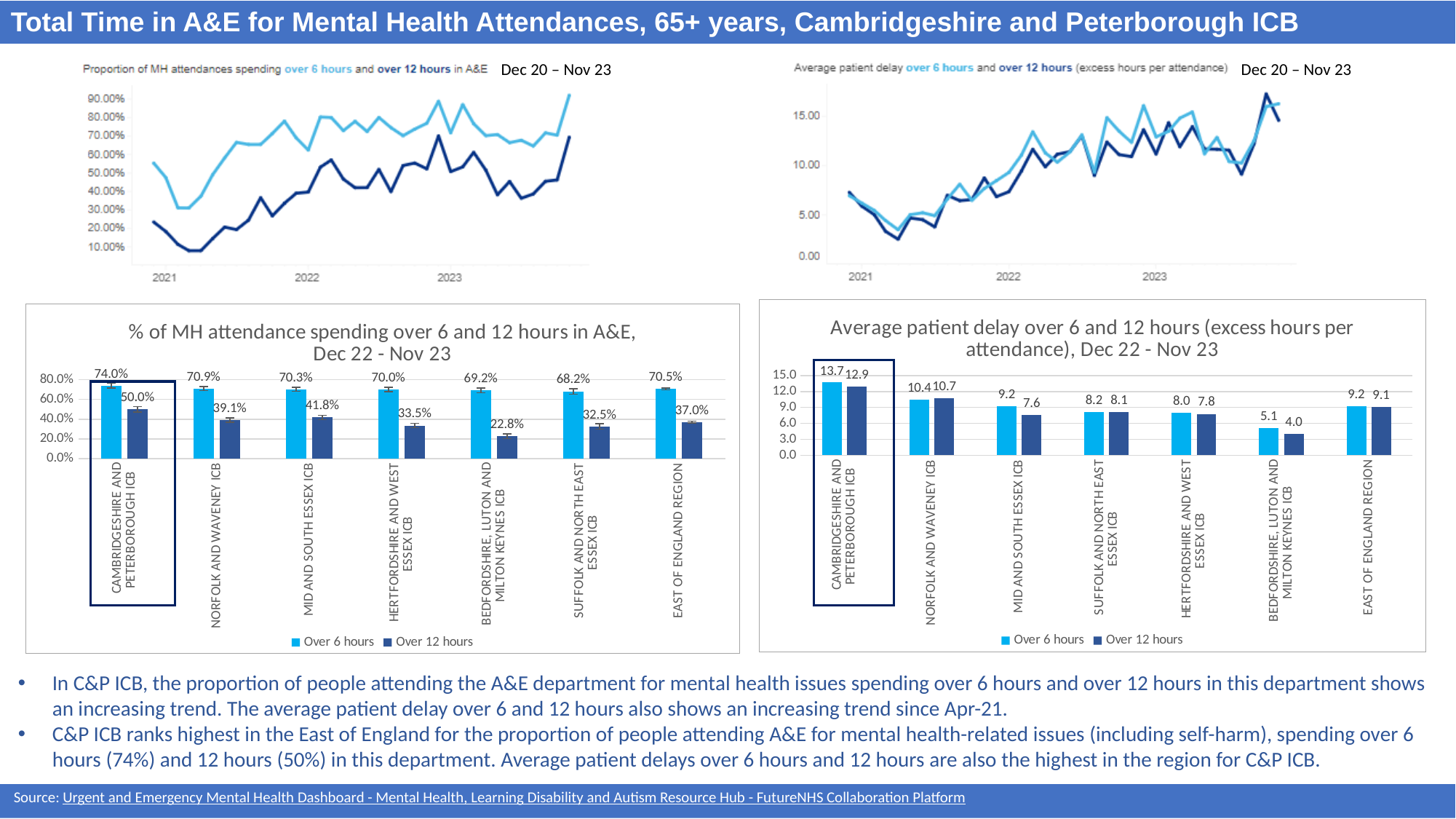
In the bottom-right chart 'Average patient delay over 6 and 12 hours', what is the difference between the 'Over 6 hours' and 'Over 12 hours' values for Cambridgeshire and Peterborough ICB? 0.8 In the bottom-left chart '% of MH attendance spending over 6 and 12 hours in A&E, Dec 22 - Nov 23', what is the 'Over 12 hours' value for Cambridgeshire and Peterborough ICB? 50.0% In the bottom-left chart '% of MH attendance spending over 6 and 12 hours in A&E', how many categories are shown on the x axis? 7 What kind of chart is the bottom-left chart '% of MH attendance spending over 6 and 12 hours in A&E'? Bar chart In the bottom-right chart 'Average patient delay over 6 and 12 hours', which category has the lowest 'Over 6 hours' value? Bedfordshire, Luton and Milton Keynes ICB In the bottom-right chart 'Average patient delay over 6 and 12 hours', what is the 'Over 12 hours' value for Norfolk and Waveney ICB? 10.7 In the bottom-left chart '% of MH attendance spending over 6 and 12 hours in A&E', which ICB has the lowest 'Over 12 hours' value? Bedfordshire, Luton and Milton Keynes ICB In the bottom-right chart 'Average patient delay over 6 and 12 hours', which is larger for Mid and South Essex ICB: the 'Over 6 hours' value or the 'Over 12 hours' value? Over 6 hours In the bottom-right chart 'Average patient delay over 6 and 12 hours (excess hours per attendance), Dec 22 - Nov 23', what is the 'Over 6 hours' value for Cambridgeshire and Peterborough ICB? 13.7 How many series does the legend of the bottom-right chart 'Average patient delay over 6 and 12 hours' list? 2 In the bottom-left chart '% of MH attendance spending over 6 and 12 hours in A&E', what is the difference between the 'Over 6 hours' and 'Over 12 hours' values for Hertfordshire and West Essex ICB? 36.5% In the bottom-left chart '% of MH attendance spending over 6 and 12 hours in A&E', which category has the highest 'Over 6 hours' value? Cambridgeshire and Peterborough ICB